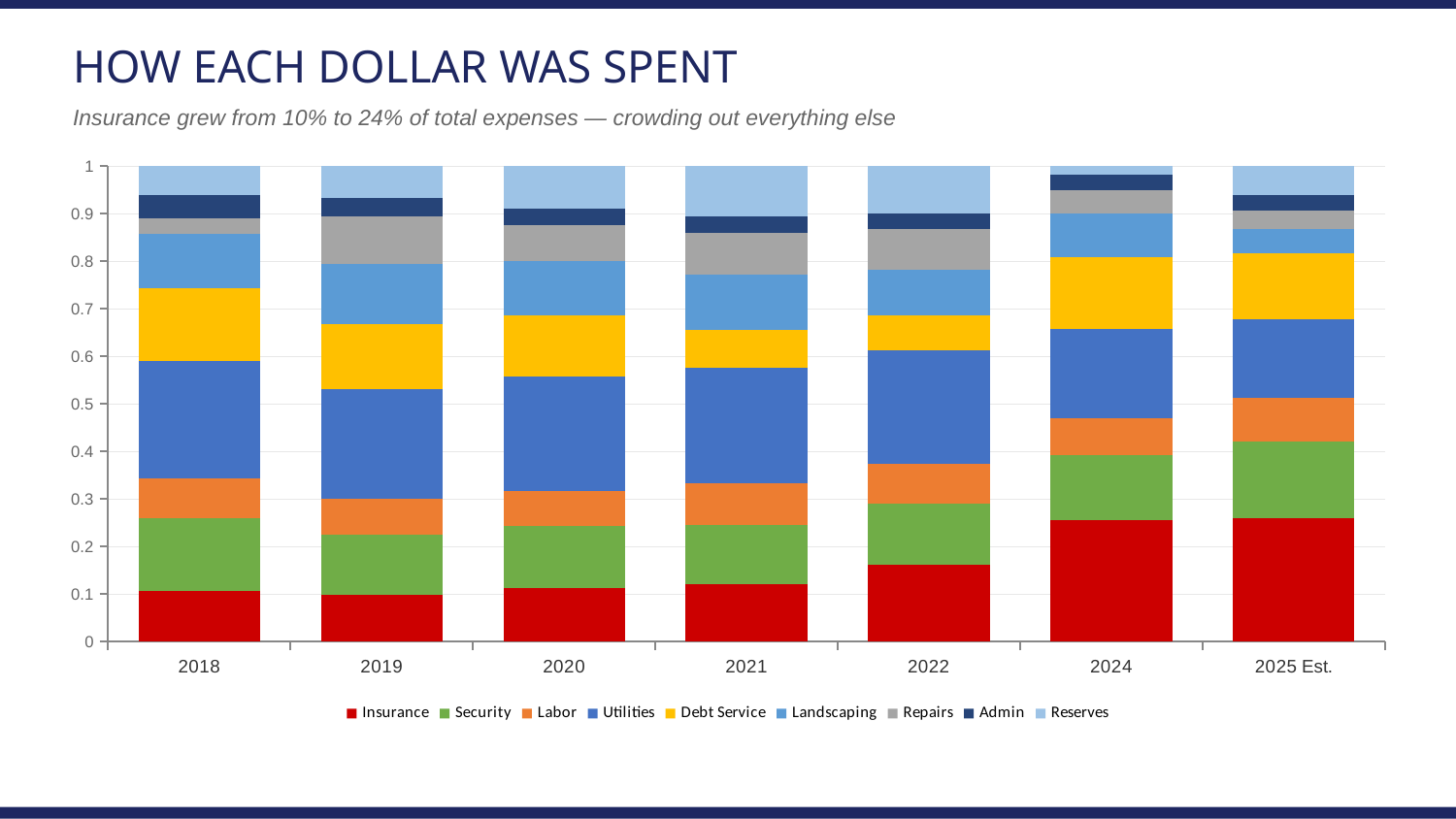
How many series does the legend list? 9 Which expense category is shown in red at the bottom of each bar? Insurance What is the title of the chart slide? HOW EACH DOLLAR WAS SPENT Which year has the smallest Reserves segment? 2024 Is the Insurance share in 2018 greater or less than 0.2? less Which is larger, the Reserves share in 2021 or in 2024? 2021 What kind of chart is shown on the slide? Stacked bar chart Is the Insurance share in 2024 greater or less than 0.2? greater Is the Insurance share in 2022 greater or less than 0.2? less Which is larger, the Insurance share in 2022 or in 2018? 2022 How many years (categories) are shown on the x axis? 7 Does the Insurance share generally rise or fall from 2018 to 2025 Est.? rise